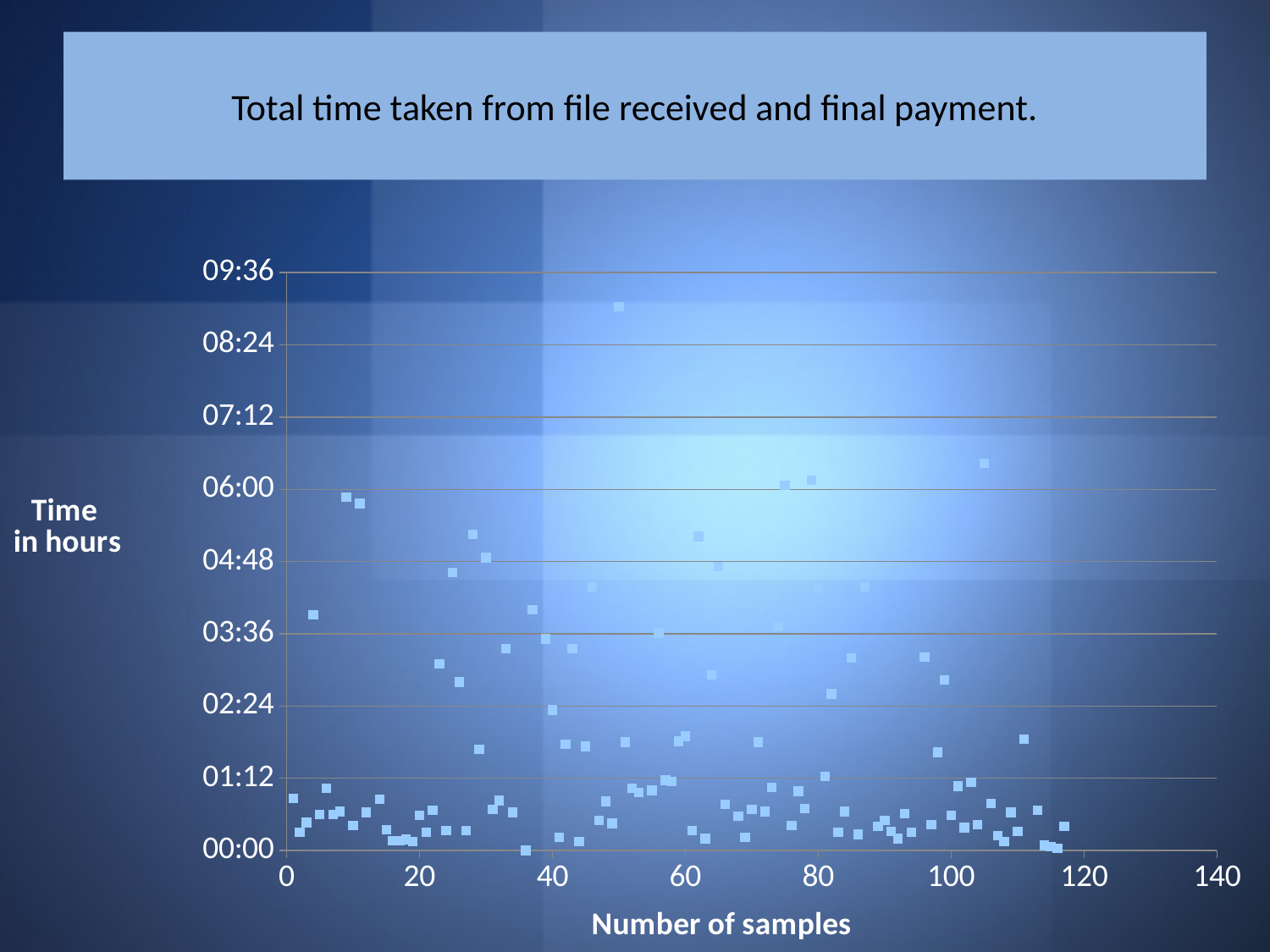
Which is larger: the value for the point near sample 50 or the value for the point near sample 105? sample 50 Is the value for the point near sample 4 greater or less than 03:36? greater How many points are plotted above the 07:12 gridline? 1 Is the value for the point near sample 105 greater or less than 06:00? greater Is the value for the point near sample 62 greater or less than 04:48? greater What is the title of the chart? Total time taken from file received and final payment. What kind of chart is shown on the slide? Scatter chart What is the label of the x axis? Number of samples What is the highest value shown on the y axis? 09:36